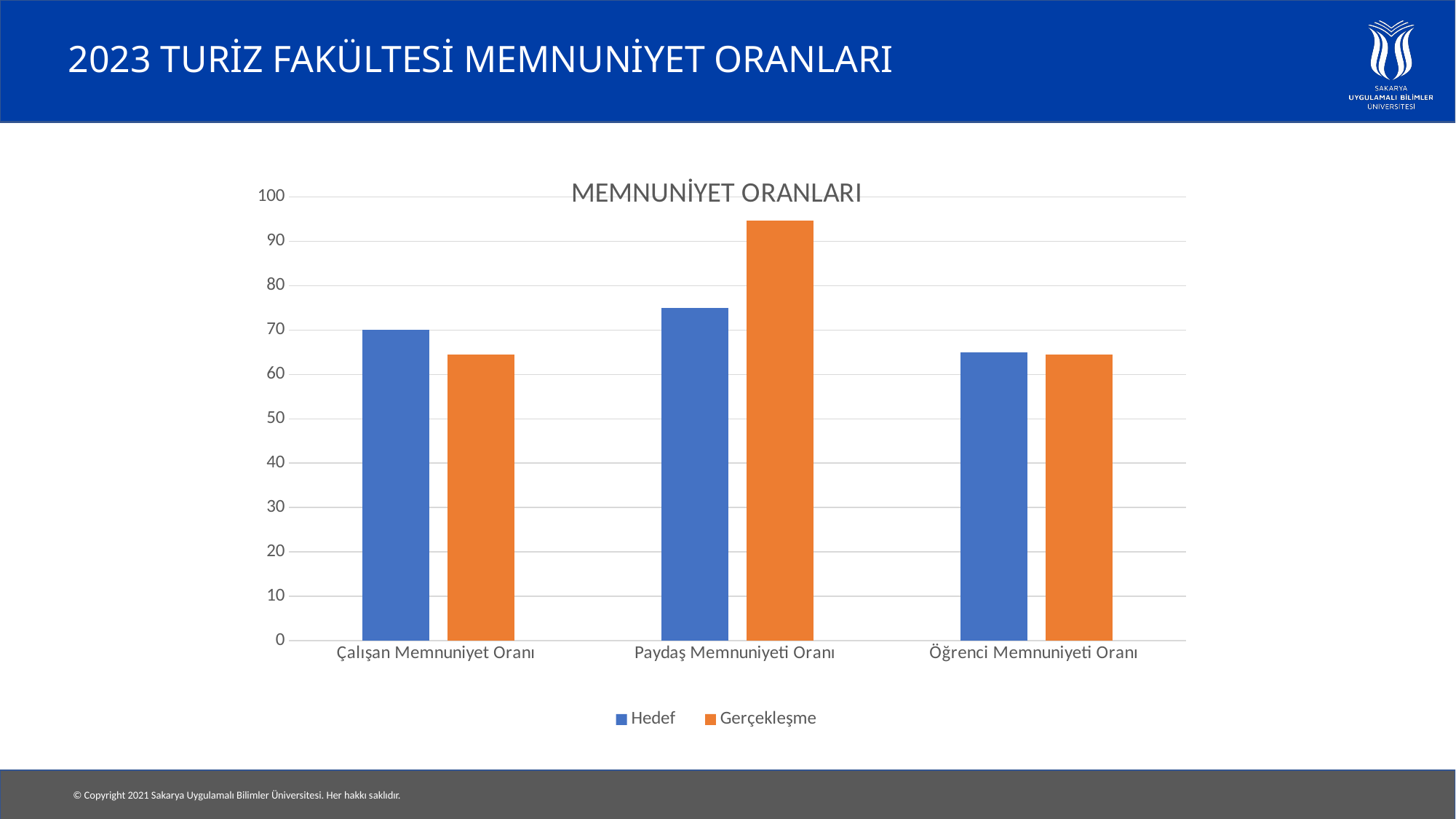
Is the Hedef value for Paydaş Memnuniyeti Oranı greater or less than 70? greater For Paydaş Memnuniyeti Oranı, which is larger: Hedef or Gerçekleşme? Gerçekleşme How many series does the legend list? 2 Which category has the highest Gerçekleşme value? Paydaş Memnuniyeti Oranı What kind of chart is shown on the slide? Bar chart What is the Hedef value for Çalışan Memnuniyet Oranı? 70 What is the title of the chart? MEMNUNİYET ORANLARI How many categories are shown on the x axis? 3 Is the Gerçekleşme value for Paydaş Memnuniyeti Oranı greater or less than 90? greater Which category has the highest Hedef value? Paydaş Memnuniyeti Oranı For Çalışan Memnuniyet Oranı, which is larger: Hedef or Gerçekleşme? Hedef Is the Gerçekleşme value for Çalışan Memnuniyet Oranı greater or less than 70? less